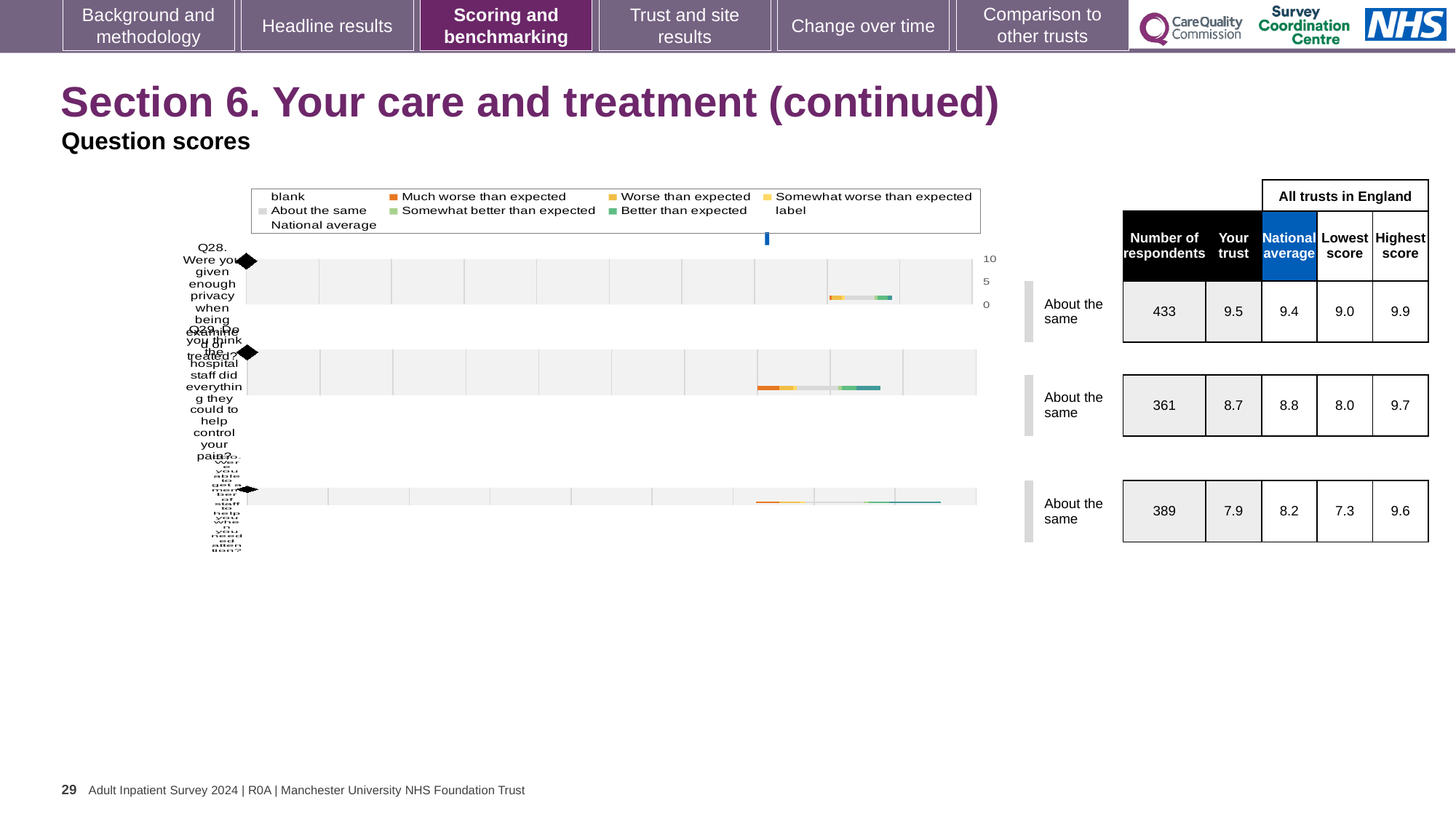
For Q28, what is the difference between the highest score and the lowest score across all trusts in England? 0.9 How many respondents answered Q30? 389 What is the lowest score among all trusts in England for Q30? 7.3 For Q29, which is larger: the 'Your trust' score or the national average? National average What colour represents 'Much worse than expected' in the legend? Orange Which question has the highest 'Your trust' score? Q28 Which question has the lowest 'Your trust' score? Q30 What is the national average score for Q29 (staff did everything to help control pain)? 8.8 What benchmark category is shown for Q28? About the same How many questions are plotted on the slide? 3 What is the 'Your trust' score for Q28 (privacy when being examined or treated)? 9.5 What kind of chart is used to show the question scores? Bar chart